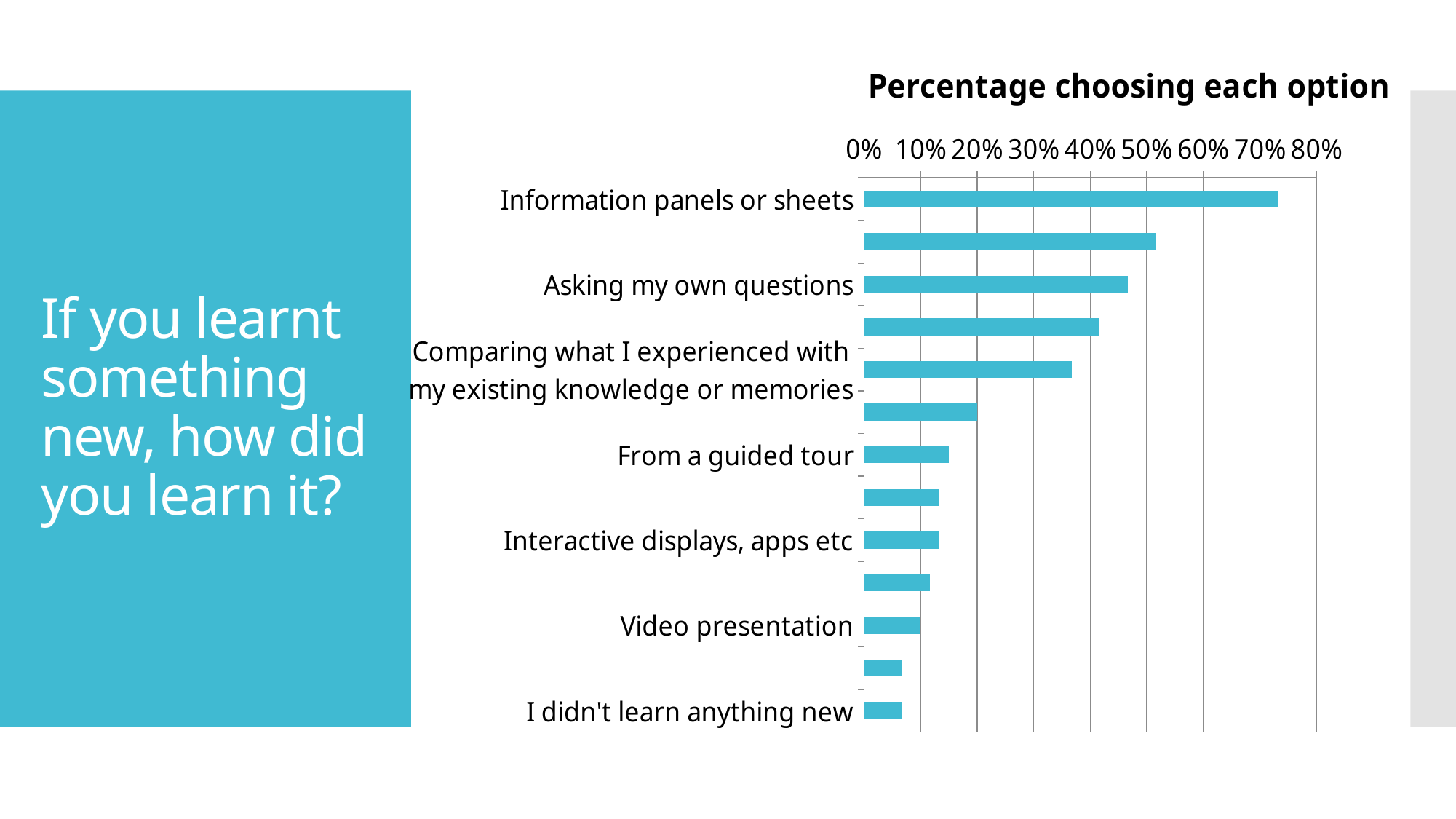
What is the highest value shown on the percentage axis? 80% Is the value for Asking my own questions greater or less than 40%? greater Is the value for Information panels or sheets greater or less than 70%? greater Is the value for From a guided tour greater or less than 20%? less Which is larger: the value for Information panels or sheets or the value for Asking my own questions? Information panels or sheets What kind of chart is shown on the slide? bar chart How many bars are plotted in the chart? 13 What is the title of the chart? Percentage choosing each option Which category has the highest percentage in the chart? Information panels or sheets Which is larger: the value for From a guided tour or the value for Video presentation? From a guided tour